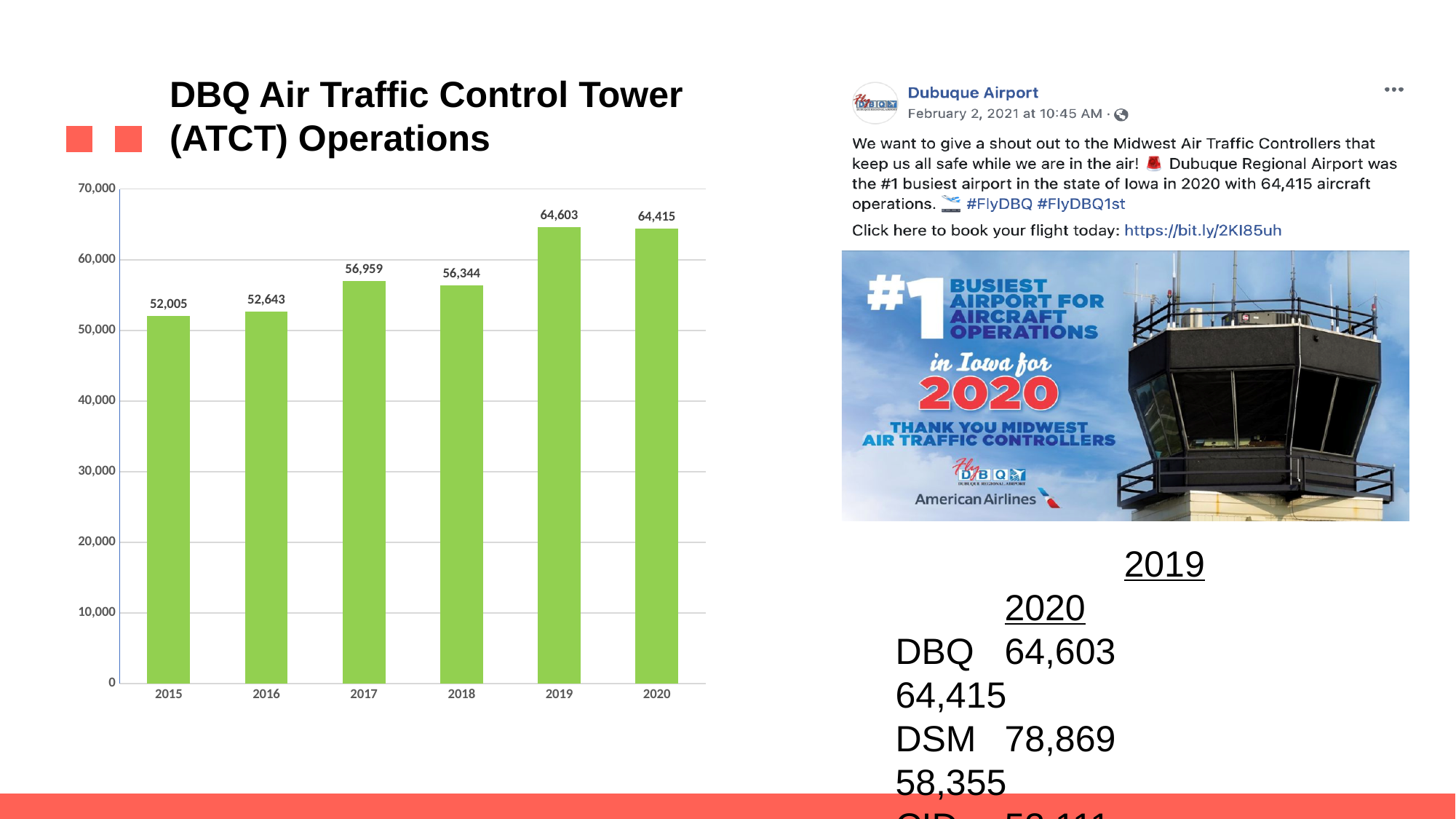
What was the value for 2015? 52,005 Which year has the lowest value? 2015 Is the value for 2019 greater or less than 60,000? greater What kind of chart is shown on the slide? Bar chart What was the value for 2017? 56,959 What was the value for 2020? 64,415 Which is larger, the value for 2016 or the value for 2018? 2018 What is the difference between the values for 2017 and 2018? 615 What is the title of the chart? DBQ Air Traffic Control Tower (ATCT) Operations How many years are shown on the x axis? 6 What is the difference between the values for 2019 and 2020? 188 Which year has the highest value? 2019